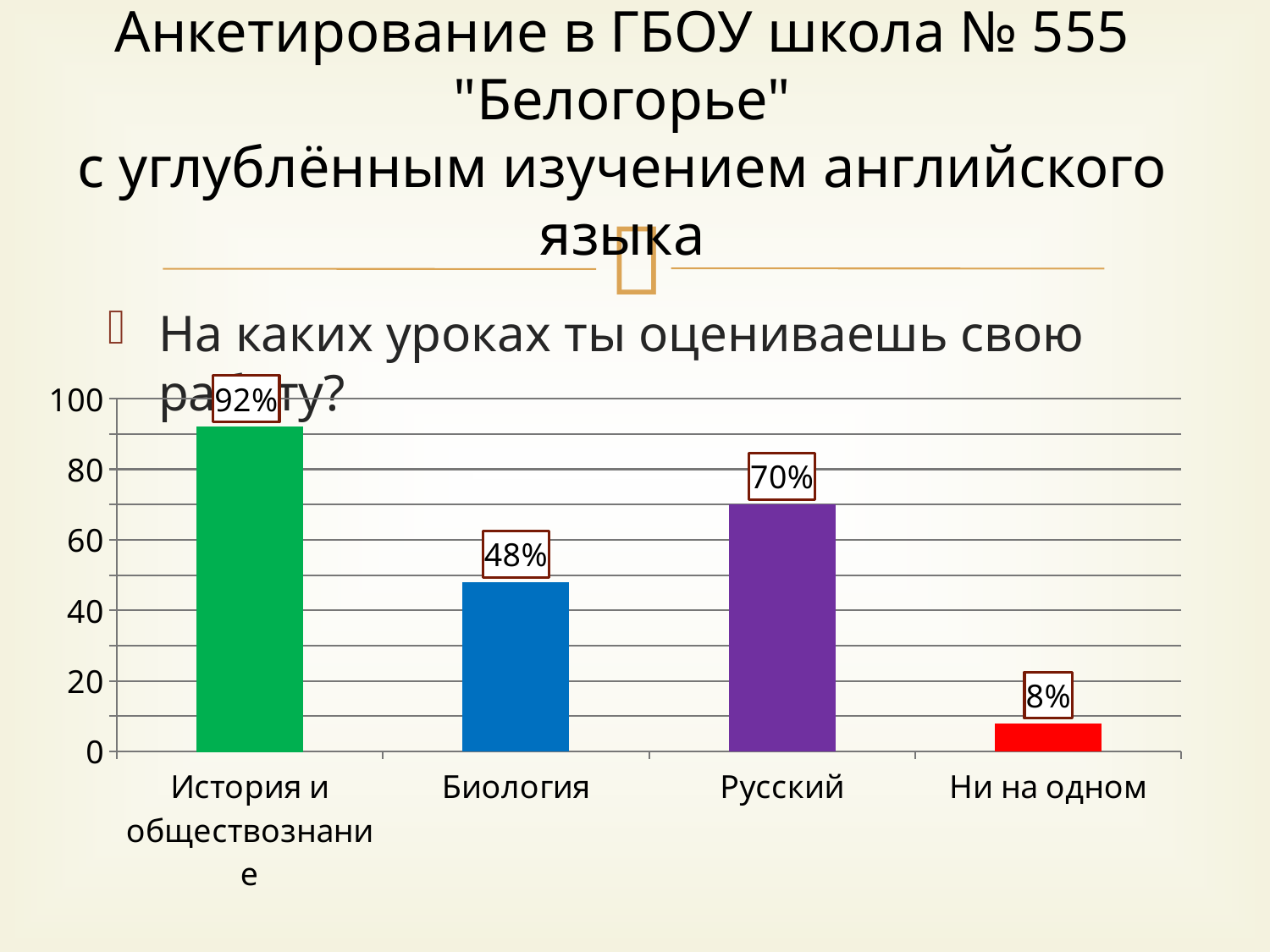
What is the value for Биология? 48% Which category has the lowest value? Ни на одном Which category has the highest value? История и обществознание Which is larger, the value for Биология or the value for Русский? Русский What is the difference between the values for Русский and Биология? 22% How many categories are shown on the x axis? 4 What is the value for История и обществознание? 92% Is the value for Биология greater or less than 60? less What colour is the bar for Русский? purple What is the value for Ни на одном? 8% What kind of chart is shown on the slide? bar chart What is the value for Русский? 70%